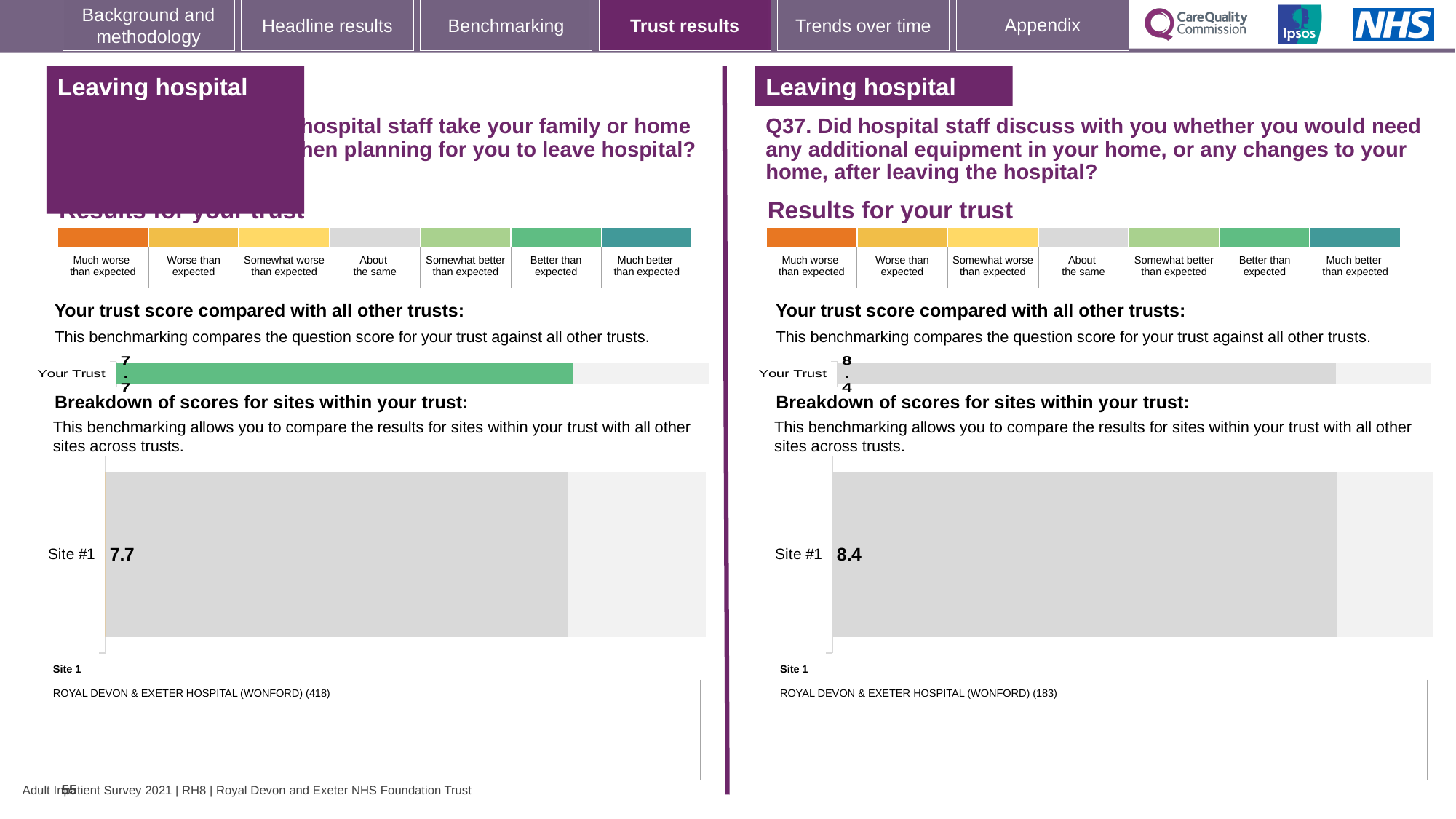
What colour is the Your Trust bar on the right half of the slide (Q37)? Grey What is the difference between the Site #1 score on the right half of the slide (Q37) and the Site #1 score on the left half? 0.7 How many sites are shown in the site breakdown chart on the left half of the slide? 1 Which is larger: the Your Trust score on the left half of the slide or the Your Trust score on the right half (Q37)? Q37 (right half), 8.4 In the site breakdown chart on the right half of the slide (Q37), what is the score for Site #1? 8.4 What kind of chart is used to show the Your Trust score on the right half of the slide (Q37)? Bar chart In the site breakdown chart on the left half of the slide, what is the score for Site #1? 7.7 How many sites are shown in the site breakdown chart on the right half of the slide (Q37)? 1 On the right half of the slide (Q37), what is the score shown for Your Trust? 8.4 Which site is listed as Site 1 in the site breakdown on the right half of the slide (Q37)? ROYAL DEVON & EXETER HOSPITAL (WONFORD) (183) What colour is the Your Trust bar on the left half of the slide? Green On the left half of the slide, what is the score shown for Your Trust? 7.7